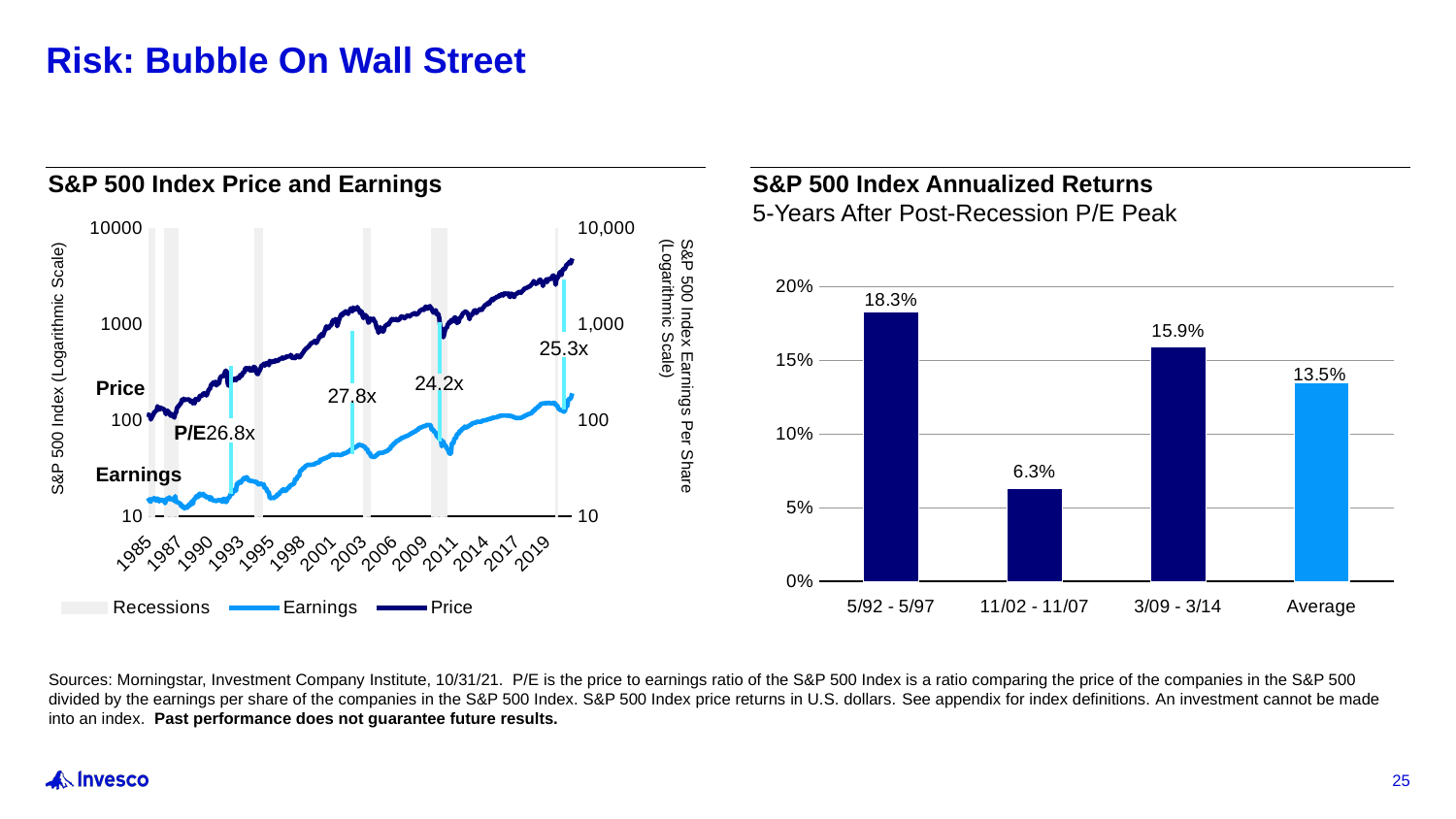
In the 'S&P 500 Index Annualized Returns' chart, which period has the highest annualized return? 5/92 - 5/97 What kind of chart is the 'S&P 500 Index Annualized Returns' chart? Bar chart In the 'S&P 500 Index Annualized Returns' chart, what is the Average value? 13.5% In the 'S&P 500 Index Price and Earnings' chart, what P/E value is labeled near 2003? 27.8x In the 'S&P 500 Index Annualized Returns' chart, which is larger: the value for 3/09 - 3/14 or the Average? 3/09 - 3/14 How many entries does the legend of the 'S&P 500 Index Price and Earnings' chart list? 3 In the 'S&P 500 Index Annualized Returns' chart, what is the value for 11/02 - 11/07? 6.3% How many bars are shown in the 'S&P 500 Index Annualized Returns' chart? 4 In the 'S&P 500 Index Annualized Returns' chart, which period has the lowest annualized return? 11/02 - 11/07 In the 'S&P 500 Index Annualized Returns' chart, what is the difference between the 5/92 - 5/97 value and the 11/02 - 11/07 value? 12.0% In the 'S&P 500 Index Annualized Returns' chart, what is the value for 5/92 - 5/97? 18.3% In the 'S&P 500 Index Annualized Returns' chart, what is the value for 3/09 - 3/14? 15.9%